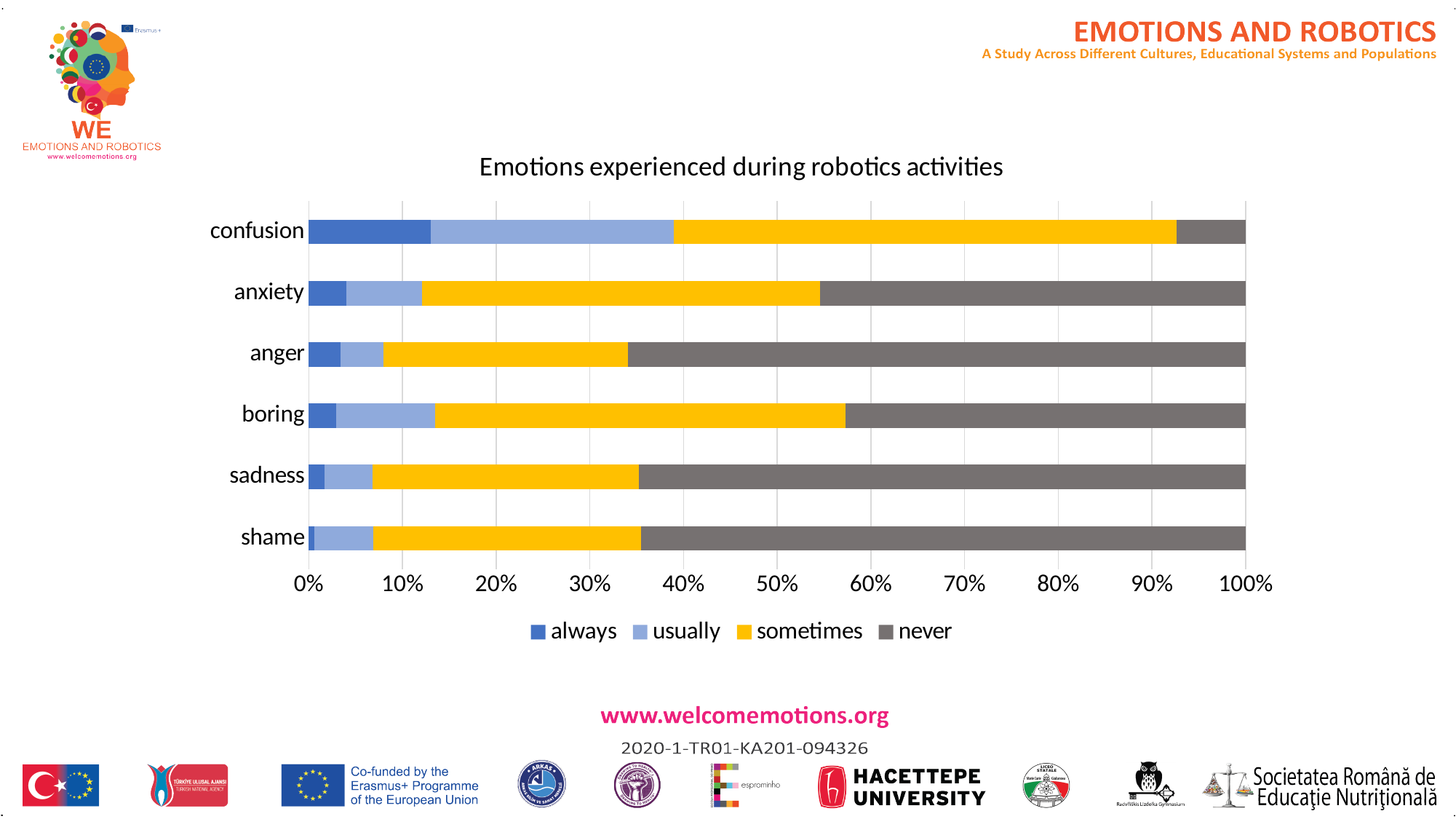
Which emotion has the largest 'always' segment? confusion What is the title of the chart? Emotions experienced during robotics activities What is the total of the stacked bar for anger? 100% Is the 'never' value for anger greater or less than 60%? greater How many emotions (categories) are plotted on the chart? 6 Which series is shown in yellow in the legend? sometimes Is the 'never' value for anxiety greater or less than 40%? greater Which has the larger 'sometimes' segment, confusion or anger? confusion Which emotion has the smallest 'never' segment? confusion What kind of chart is shown on the slide? stacked bar chart How many series does the legend list? 4 Is the 'always' value for confusion greater or less than 10%? greater